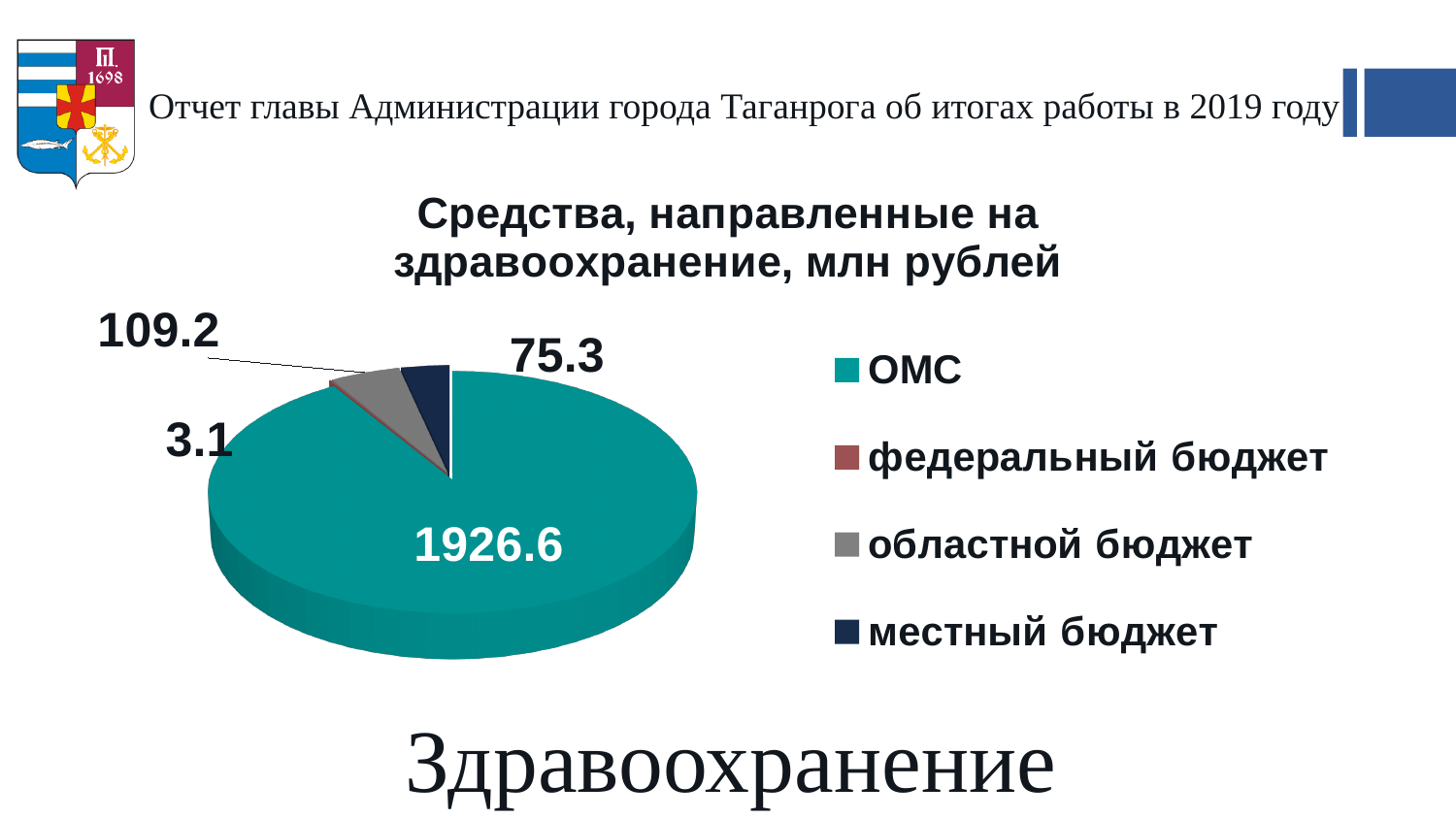
What colour is the ОМС slice in the pie chart? teal Which category has the largest slice of the pie? ОМС What is the value for областной бюджет? 109.2 What type of chart is shown on the slide? pie chart Which is larger, областной бюджет or местный бюджет? областной бюджет What is the value for федеральный бюджет? 3.1 What is the value for ОМС in the chart "Средства, направленные на здравоохранение, млн рублей"? 1926.6 What is the total of all slices in the pie chart? 2114.2 What is the difference between областной бюджет and местный бюджет? 33.9 Which category has the smallest slice of the pie? федеральный бюджет How many categories does the pie chart have? 4 What is the value for местный бюджет? 75.3